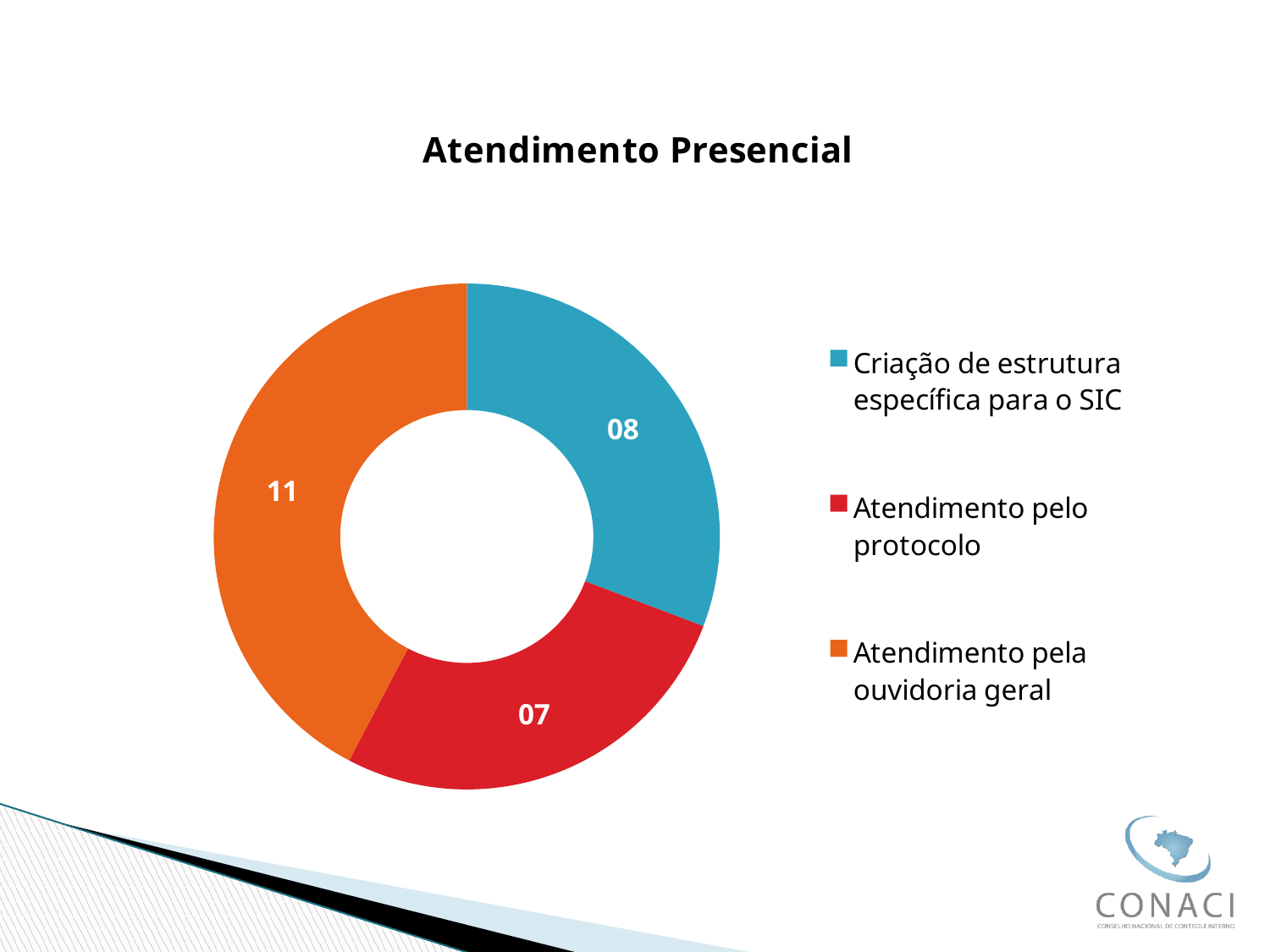
What is the value for "Atendimento pelo protocolo"? 07 How many categories does the chart show? 3 What is the value for "Atendimento pela ouvidoria geral"? 11 Which is larger: "Criação de estrutura específica para o SIC" or "Atendimento pela ouvidoria geral"? Atendimento pela ouvidoria geral What kind of chart is shown on the slide? Doughnut chart What is the difference between the values for "Criação de estrutura específica para o SIC" and "Atendimento pelo protocolo"? 1 Which category has the smallest slice? Atendimento pelo protocolo What is the difference between the values for "Atendimento pela ouvidoria geral" and "Atendimento pelo protocolo"? 4 Which category has the largest slice? Atendimento pela ouvidoria geral What is the title of the chart? Atendimento Presencial What is the total of all the slices in the chart? 26 What is the value for "Criação de estrutura específica para o SIC"? 08